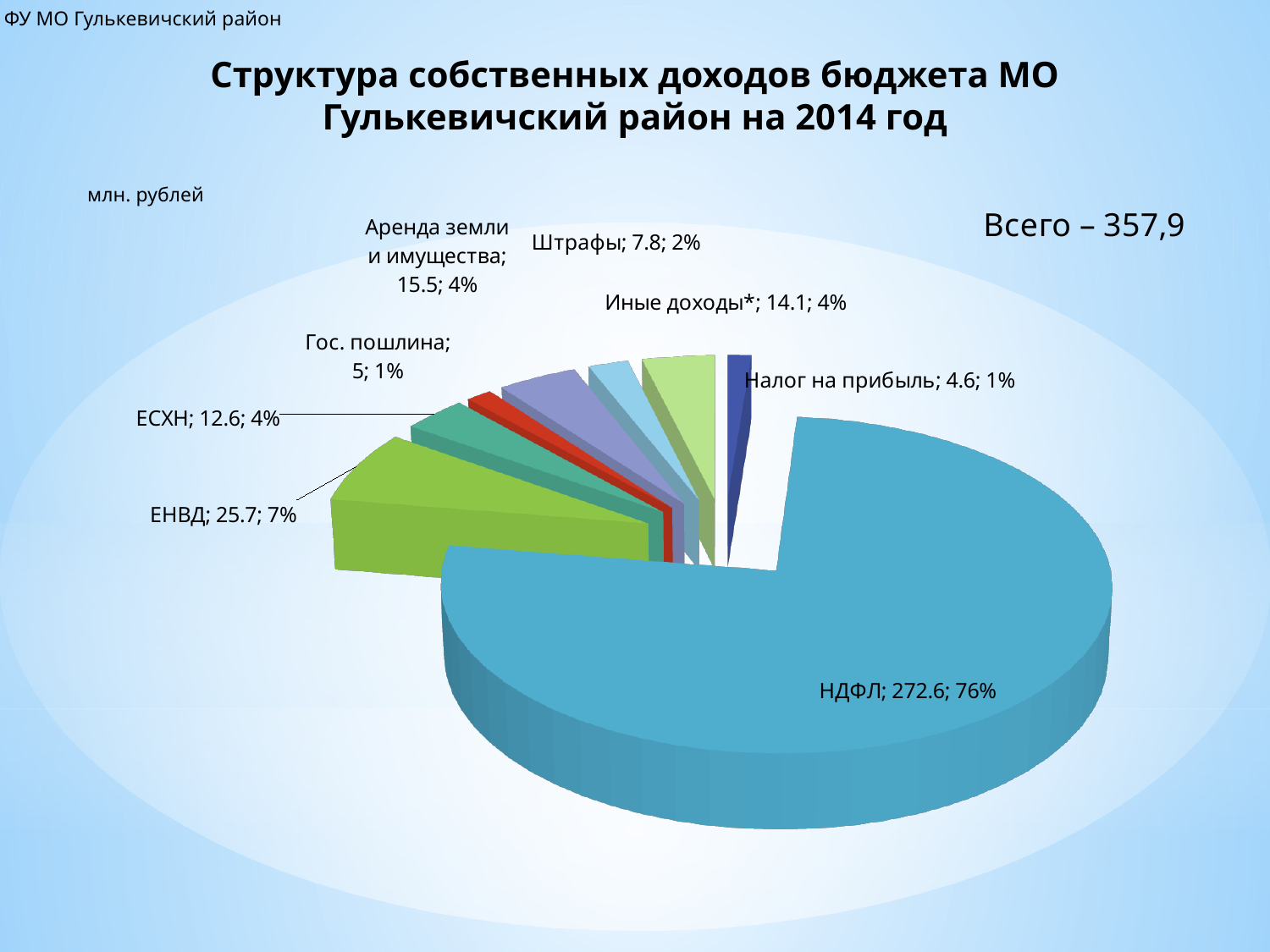
Which category has the smallest value? Налог на прибыль How many slices does the pie chart have? 8 What is the value for Аренда земли и имущества? 15.5 What total is stated on the slide for the chart (Всего)? 357,9 What is the value for НДФЛ? 272.6 What share of the pie does НДФЛ represent? 76% What is the value for ЕНВД? 25.7 What kind of chart is shown on the slide? Pie chart Which is larger, the value for Иные доходы* or the value for Аренда земли и имущества? Аренда земли и имущества Which category has the largest slice? НДФЛ What share of the pie does Штрафы represent? 2% What is the difference between the values for ЕНВД and ЕСХН? 13.1